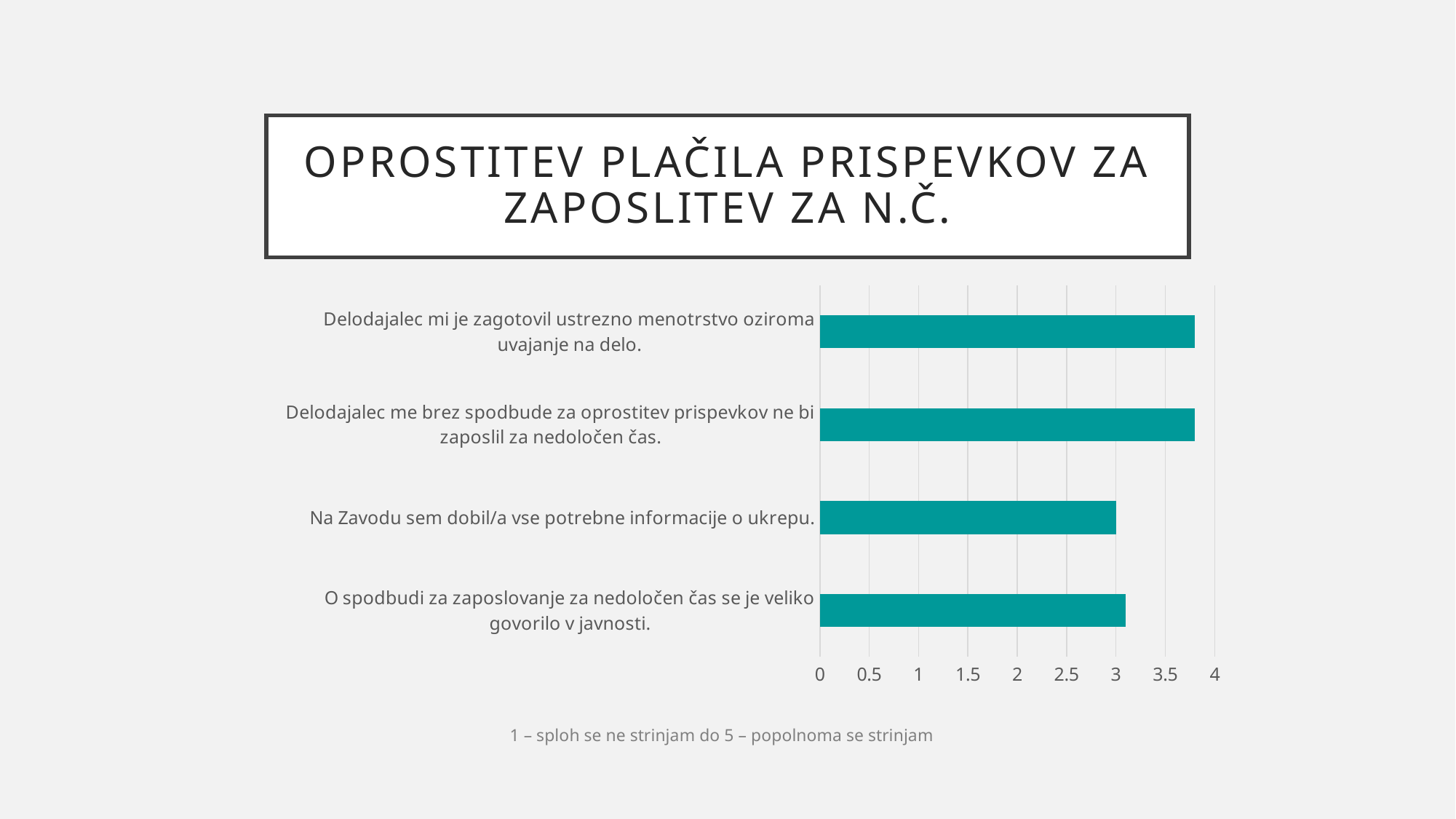
Which has the larger value: "Delodajalec mi je zagotovil ustrezno menotrstvo oziroma uvajanje na delo." or "Na Zavodu sem dobil/a vse potrebne informacije o ukrepu."? Delodajalec mi je zagotovil ustrezno menotrstvo oziroma uvajanje na delo. Which has the larger value: "O spodbudi za zaposlovanje za nedoločen čas se je veliko govorilo v javnosti." or "Delodajalec me brez spodbude za oprostitev prispevkov ne bi zaposlil za nedoločen čas."? Delodajalec me brez spodbude za oprostitev prispevkov ne bi zaposlil za nedoločen čas. Is the value for "O spodbudi za zaposlovanje za nedoločen čas se je veliko govorilo v javnosti." greater or less than 3.5? less What is the highest value shown on the chart's horizontal axis? 4 Is the value for "Delodajalec mi je zagotovil ustrezno menotrstvo oziroma uvajanje na delo." greater or less than 3.5? greater What kind of chart is shown on the slide? bar chart Is the value for "Delodajalec me brez spodbude za oprostitev prispevkov ne bi zaposlil za nedoločen čas." greater or less than 3.5? greater What is the title shown on the slide above the chart? OPROSTITEV PLAČILA PRISPEVKOV ZA ZAPOSLITEV ZA N.Č. How many categories (statements) are plotted in the chart? 4